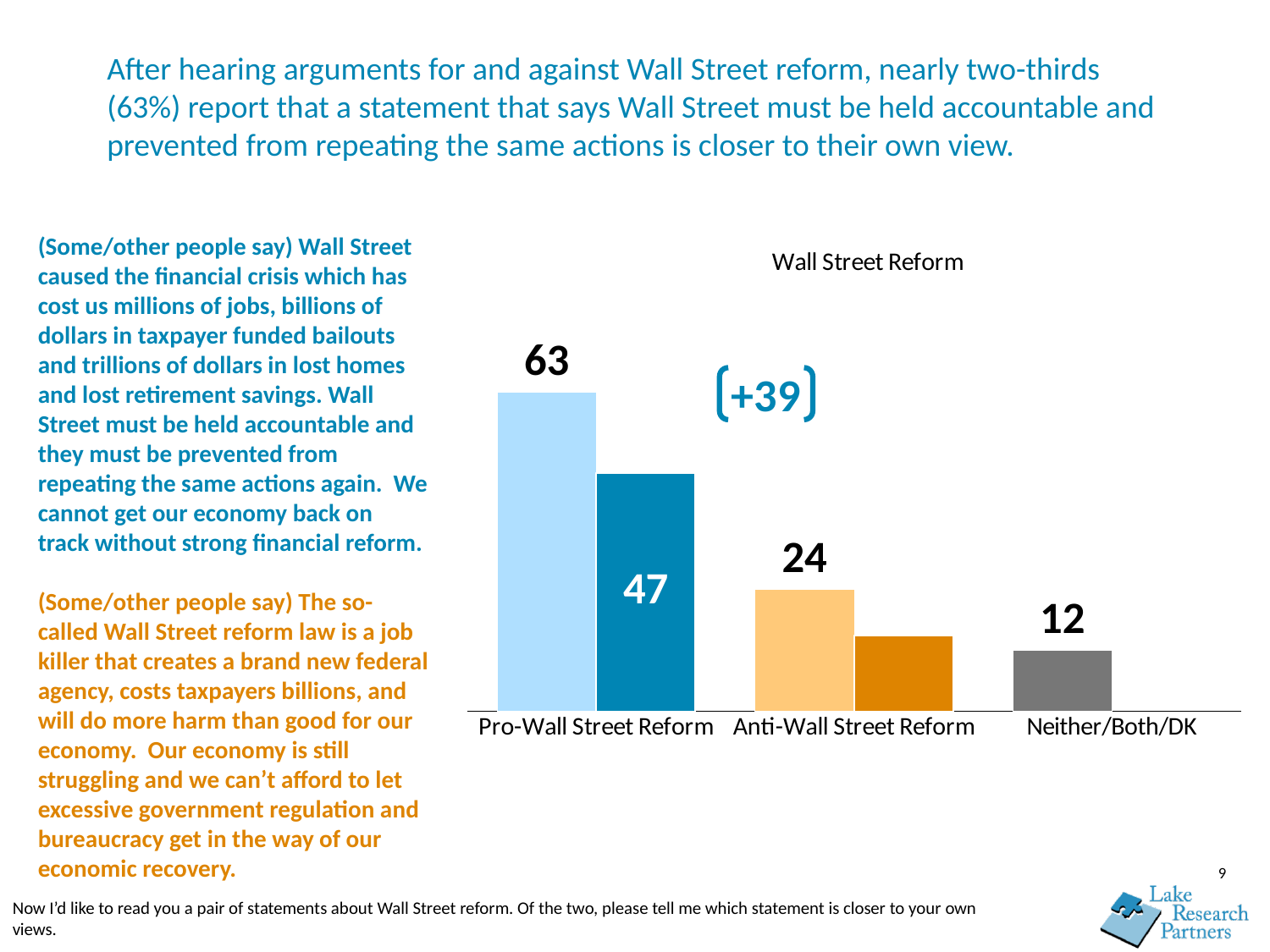
What value is shown for the light orange bar in the Anti-Wall Street Reform category? 24 What value is printed on the dark blue bar in the Pro-Wall Street Reform category? 47 What type of chart is shown on the slide? Bar chart What is the difference between the 63 for Pro-Wall Street Reform and the 24 for Anti-Wall Street Reform? 39 Which category has the tallest bar? Pro-Wall Street Reform What value is shown for the Neither/Both/DK category? 12 What is the difference between the two labeled bars in the Pro-Wall Street Reform category (63 and 47)? 16 Which category has the lowest value? Neither/Both/DK What is the title of the chart? Wall Street Reform How many categories are shown on the x axis of the chart? 3 Which is larger: the value for Anti-Wall Street Reform (24) or the value for Neither/Both/DK (12)? Anti-Wall Street Reform What value is shown for the light blue bar in the Pro-Wall Street Reform category? 63